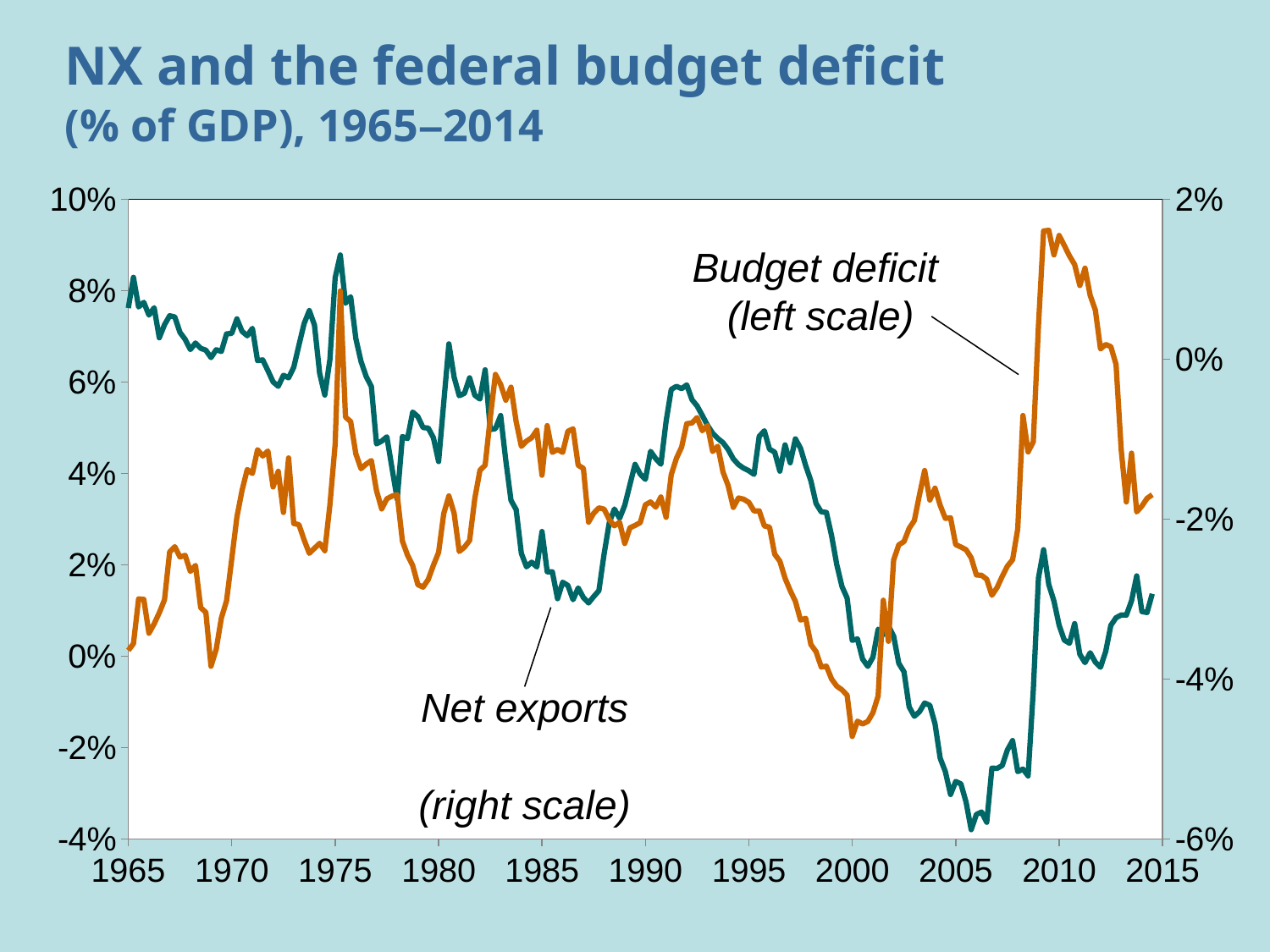
What is the title of the chart? NX and the federal budget deficit (% of GDP), 1965–2014 Does the net exports line rise or fall between 1997 and 2006? fall Is the budget deficit value around 2000 greater or less than 0% on the left scale? less Is the budget deficit value around 2009–2010 greater or less than 8% on the left scale? greater Is the net exports value around 2006 greater or less than -4% on the right scale? less What kind of chart is shown on the slide? line chart Which series is plotted against the right scale? Net exports Does the budget deficit line rise or fall between 1992 and 2000? fall How many data series are plotted on the chart? 2 What is the lowest value shown on the right-hand axis? -6% Does the budget deficit line rise or fall between 2010 and 2014? fall